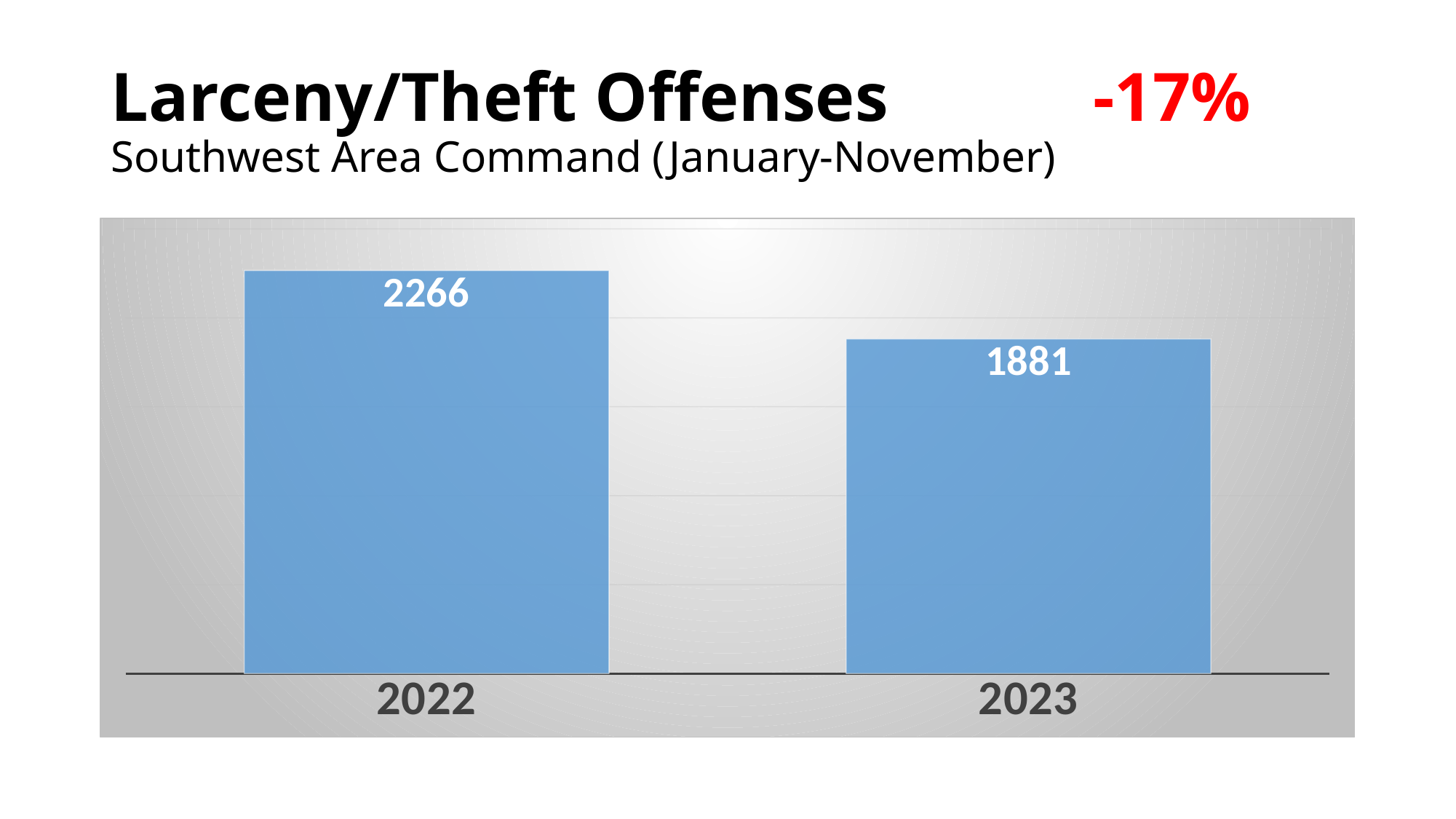
Which is larger, the value for 2022 or the value for 2023? 2022 How many categories are shown on the x axis? 2 What is the title of the chart? Larceny/Theft Offenses Which year has the lowest value? 2023 Do the values rise or fall from 2022 to 2023? fall What is the value for 2023? 1881 What percentage change is shown in red on the slide? -17% What is the difference between the 2022 and 2023 values? 385 What kind of chart is shown on the slide? bar chart Which year has the highest value? 2022 What is the value for 2022? 2266